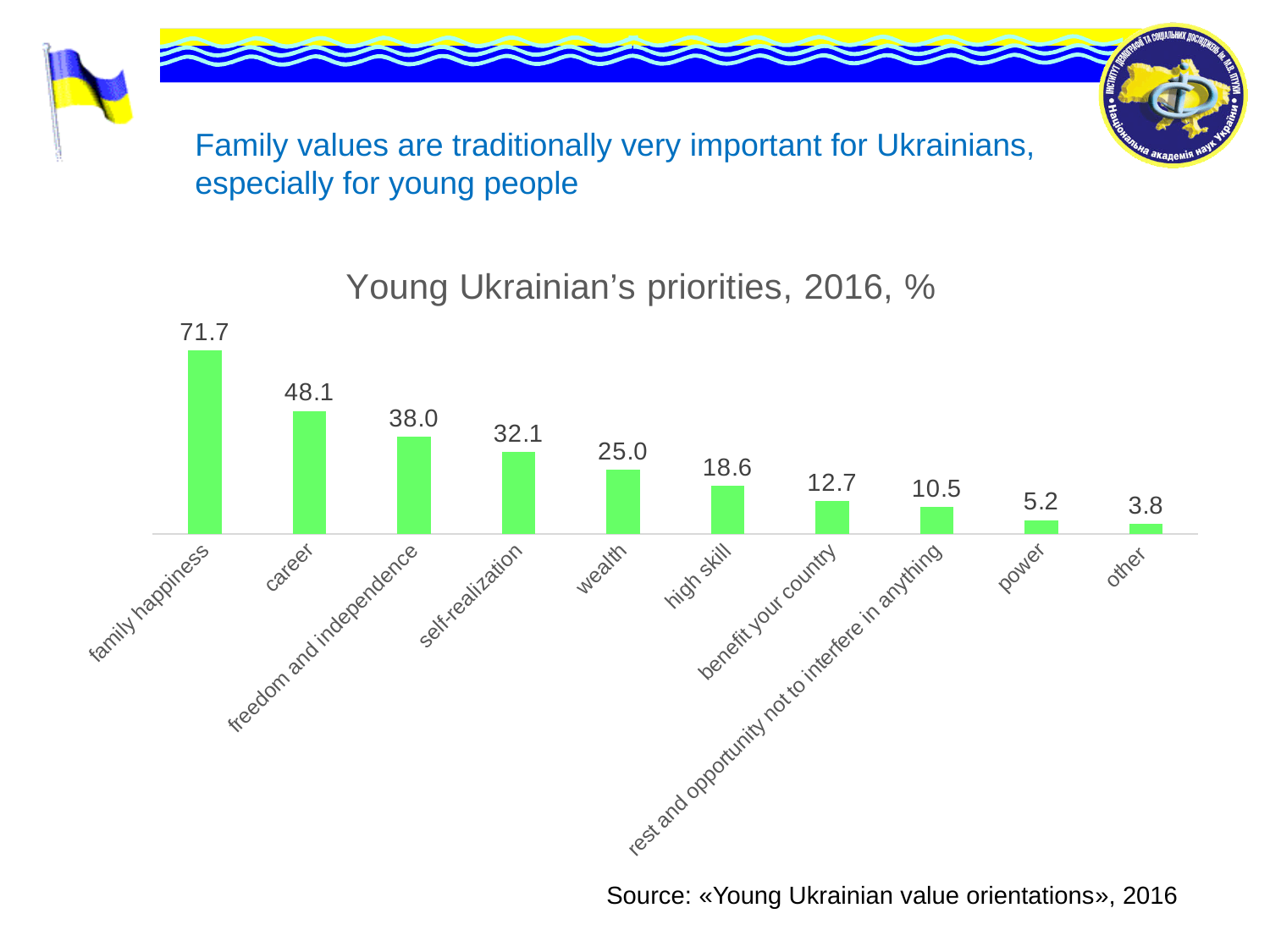
What is the value for career? 48.1 What kind of chart is shown on the slide? bar chart Which category has the highest value? family happiness How many categories are shown in the chart? 10 What is the title of the chart? Young Ukrainian’s priorities, 2016, % Which category has the lowest value? other What is the value for benefit your country? 12.7 What is the value for family happiness? 71.7 What is the difference between the values for family happiness and career? 23.6 What is the value for power? 5.2 What is the difference between the values for wealth and high skill? 6.4 Which is larger, the value for self-realization or the value for wealth? self-realization